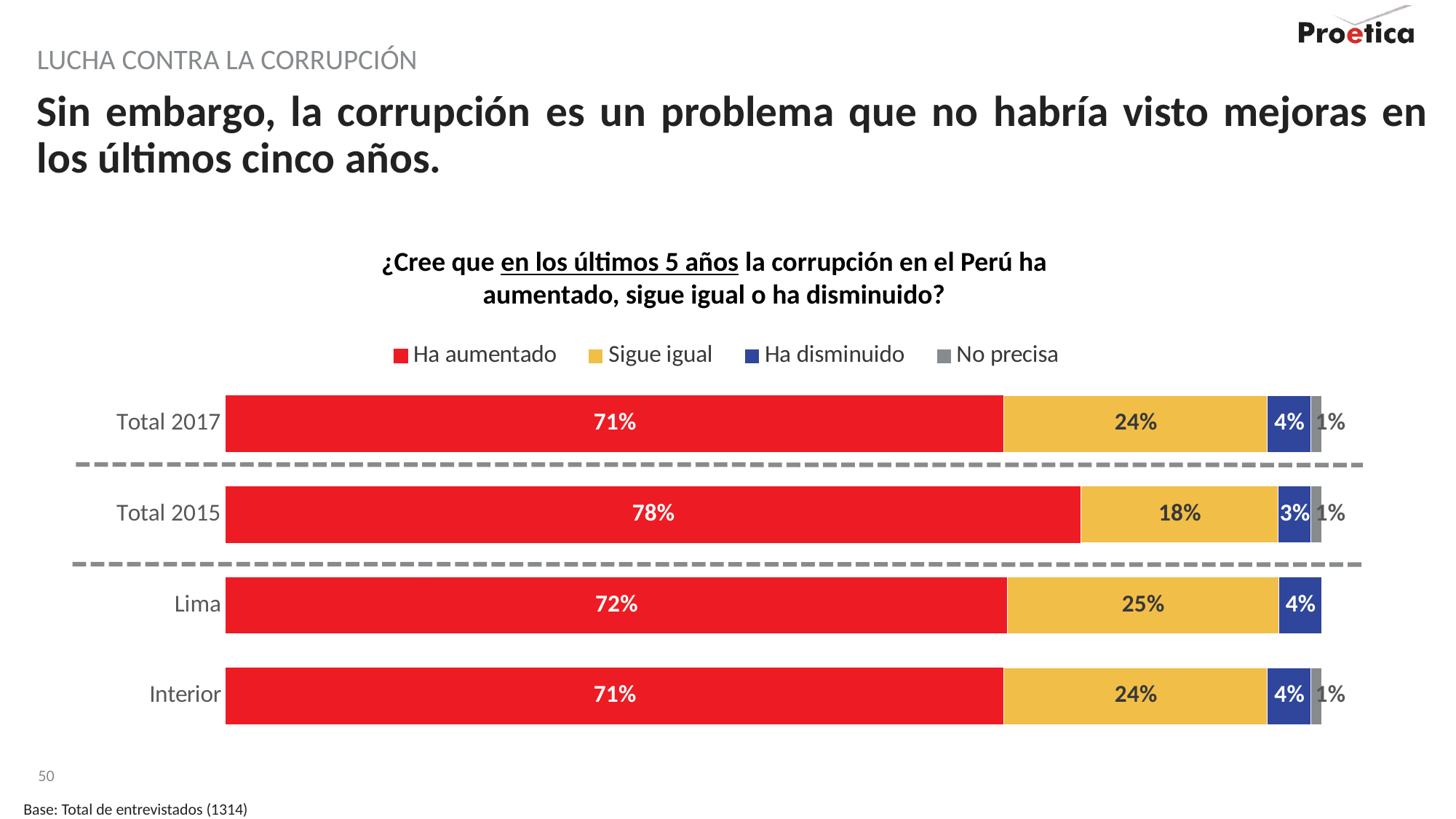
What kind of chart is shown on the slide? Stacked bar chart What percentage of Total 2017 respondents said corruption 'Ha aumentado'? 71% What is the 'No precisa' value for Interior? 1% Which category has the lowest 'Sigue igual' value? Total 2015 What is the 'Sigue igual' value for Total 2015? 18% What is the difference between the 'Ha aumentado' values for Total 2015 and Total 2017? 7 percentage points How many categories (bars) are shown in the chart? 4 How many series does the legend list? 4 Which colour represents 'Ha disminuido' in the chart? Blue Which is larger: the 'Sigue igual' value for Lima or for Interior? Lima What is the 'Ha disminuido' value for Lima? 4% Which category has the highest 'Ha aumentado' value? Total 2015